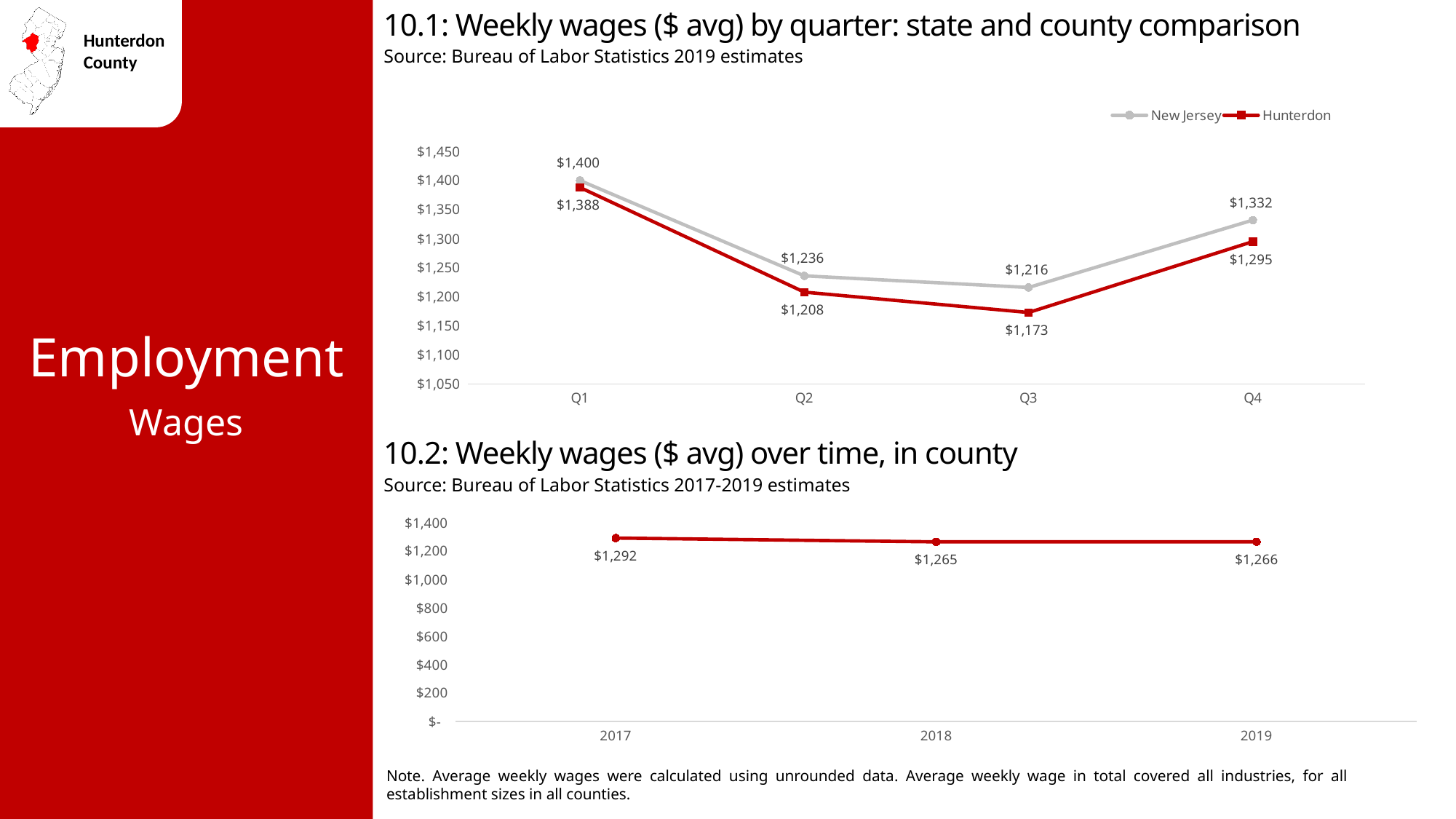
In chart 10.2, what is the weekly wage in 2017? $1,292 In chart 10.1, which quarter has the lowest Hunterdon weekly wage? Q3 In chart 10.1, what is the New Jersey weekly wage in Q1? $1,400 In chart 10.1, what is the difference between the New Jersey and Hunterdon weekly wages in Q4? $37 In chart 10.1, how many quarters are shown on the x axis? 4 What kind of chart is chart 10.2? Line chart In chart 10.2, what is the difference between the 2017 and 2018 weekly wages? $27 In chart 10.1, which quarter has the highest New Jersey weekly wage? Q1 In chart 10.1, which is larger in Q2: the New Jersey wage or the Hunterdon wage? New Jersey In chart 10.1, how many series does the legend list? 2 In chart 10.1, what is the Hunterdon weekly wage in Q3? $1,173 In chart 10.1, what colour is the Hunterdon line? Red